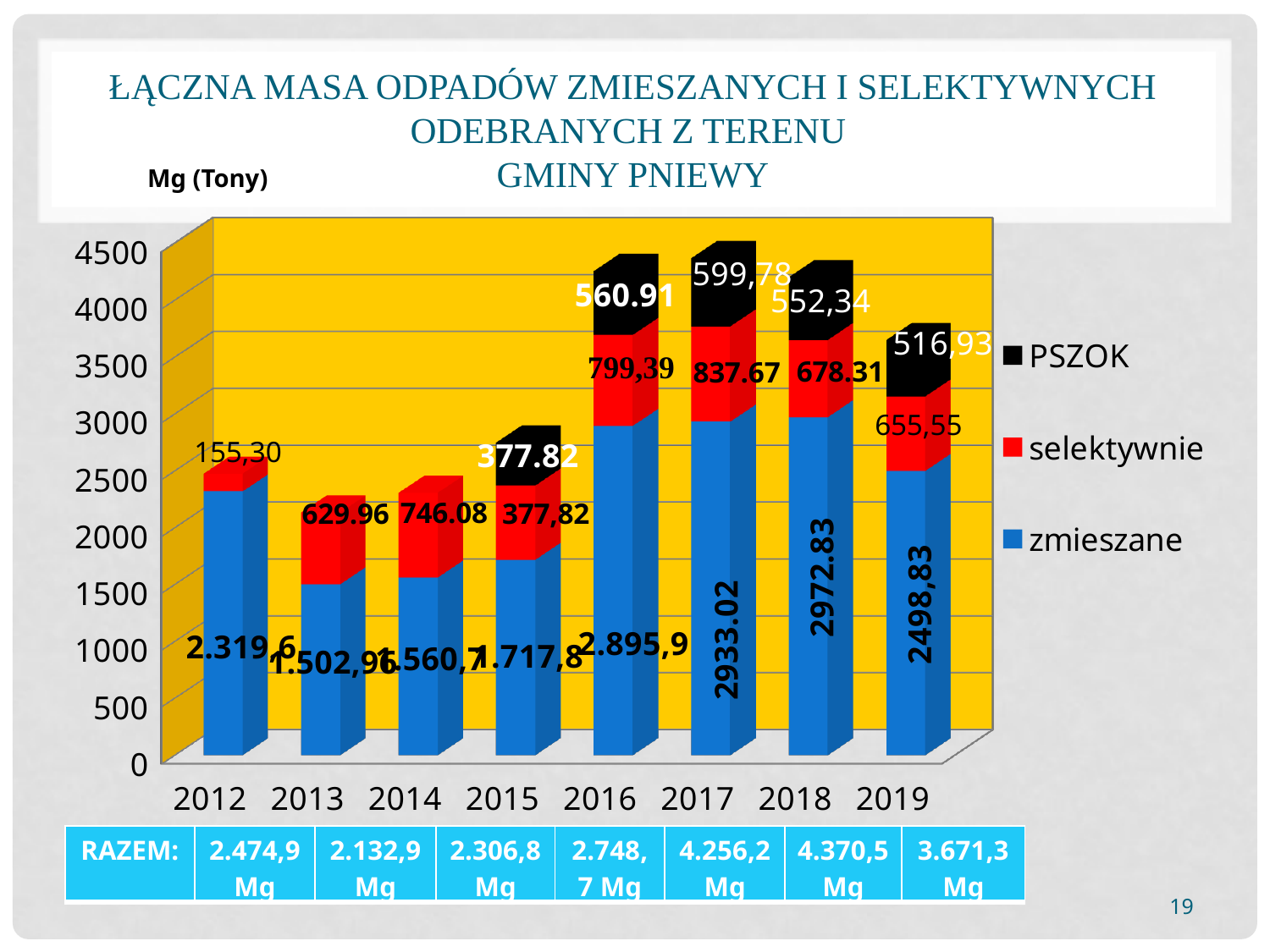
What is the PSZOK value for 2019? 516,93 In which year is the selektywnie value the lowest? 2012 How many series does the legend list? 3 Which year has the larger selektywnie value, 2013 or 2014? 2014 What is the difference between the selektywnie values for 2017 and 2018? 159.36 In which year is the selektywnie value the highest? 2017 What is the zmieszane value for 2018? 2972.83 What is the value of the selektywnie series for 2017? 837.67 Which colour represents the PSZOK series in the legend? black What kind of chart is shown on the slide? stacked bar chart How many years are shown on the x axis? 8 What is the PSZOK value for 2016? 560.91